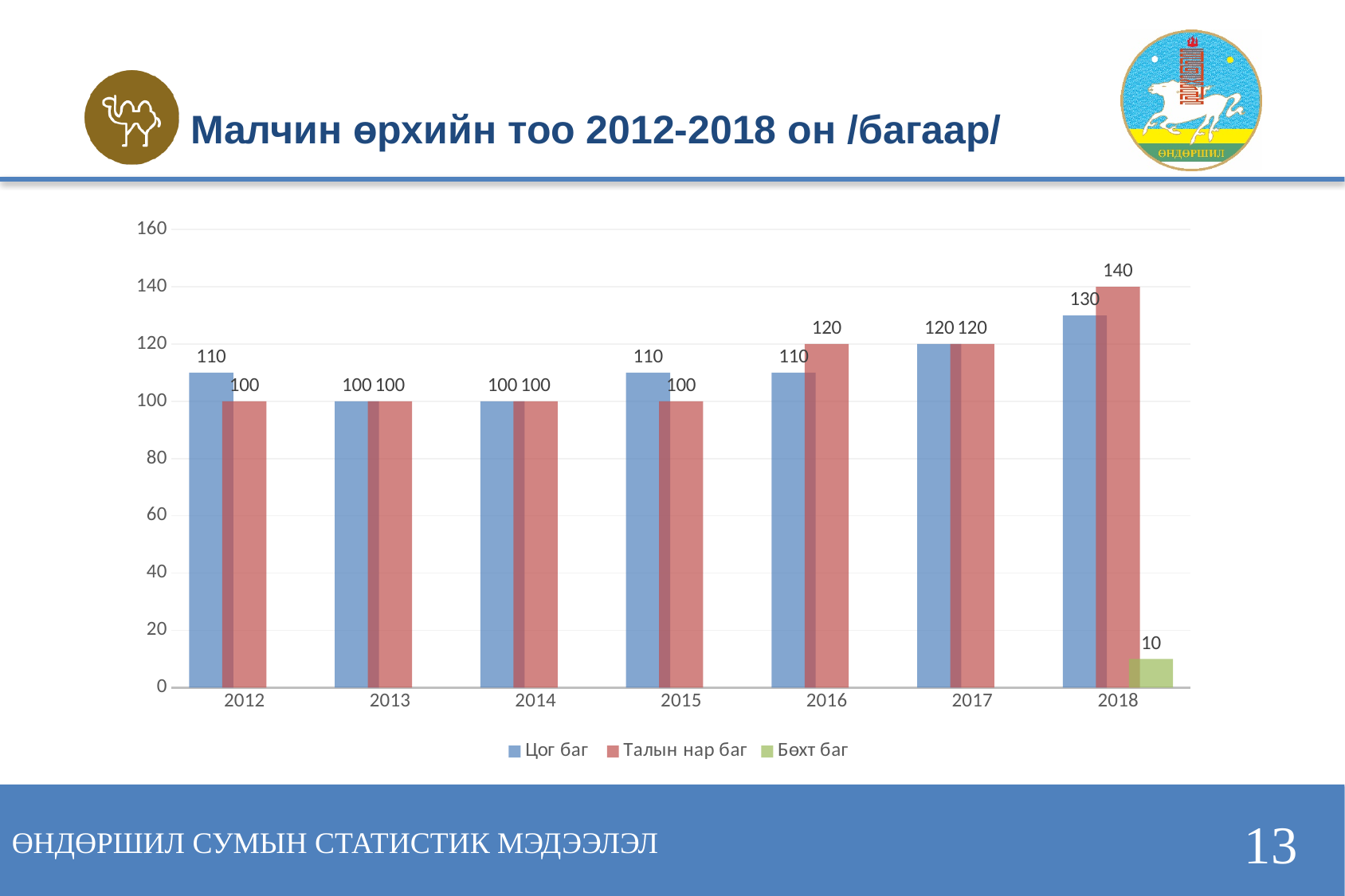
What is the title of the chart on the slide? Малчин өрхийн тоо 2012-2018 он /багаар/ What is the value for Бөхт баг in 2018? 10 What is the difference between Талын нар баг and Цог баг in 2018? 10 What is the difference between Цог баг in 2018 and Цог баг in 2012? 20 How many years are shown on the x axis? 7 Does the value for Талын нар баг rise or fall from 2015 to 2018? Rise What kind of chart is shown on the slide? Bar chart What is the value for Цог баг in 2018? 130 In which year is the value for Талын нар баг highest? 2018 Which is larger in 2012, Цог баг or Талын нар баг? Цог баг What is the value for Талын нар баг in 2016? 120 How many series does the legend list? 3